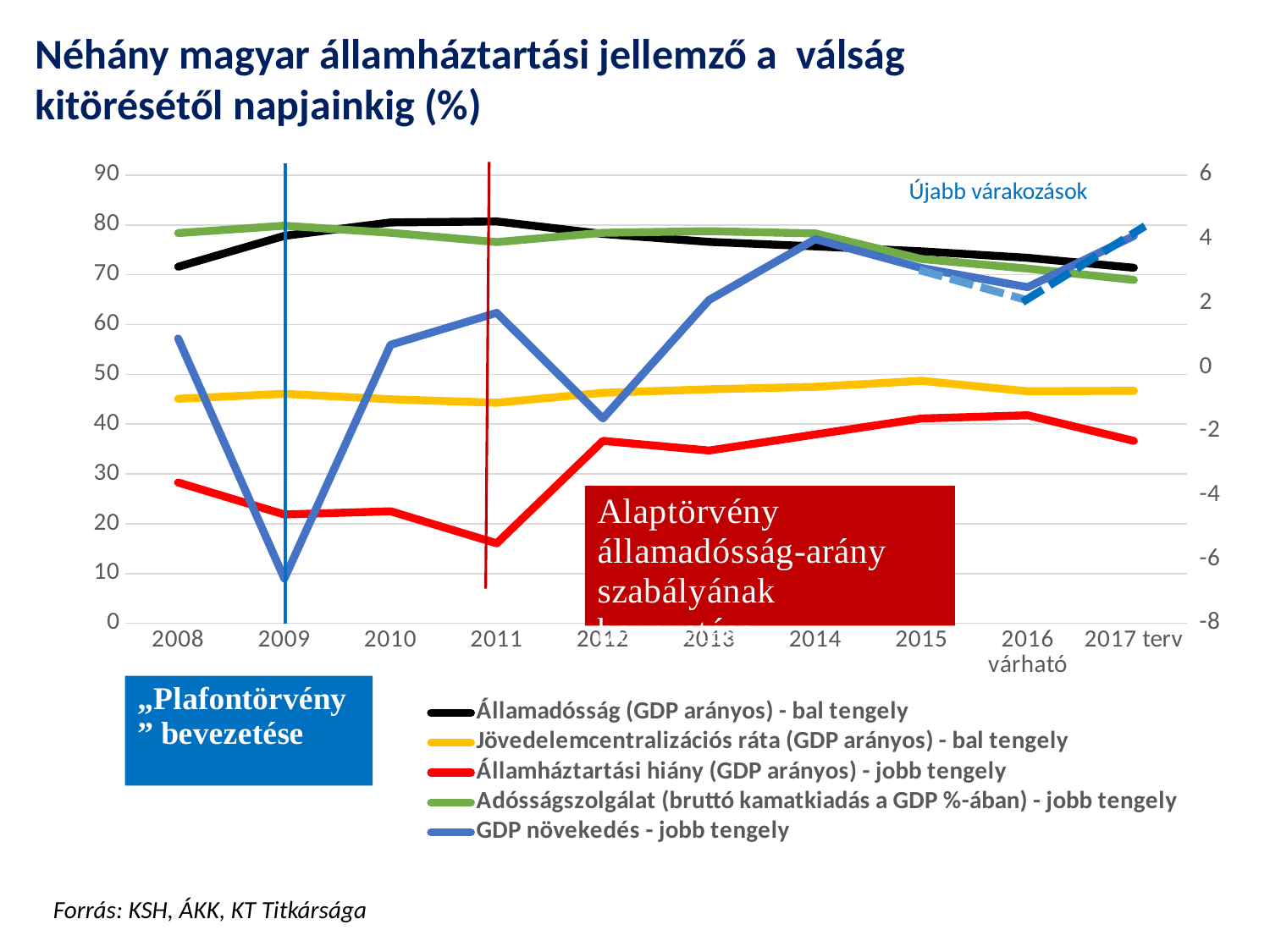
Which is larger for Államadósság (GDP arányos): the value in 2011 or in 2017 terv? 2011 Is the value for Államháztartási hiány (GDP arányos) in 2011 greater or less than -4 on the right axis? less Does Államadósság (GDP arányos) rise or fall from 2011 to 2017 terv? fall Is the value for GDP növekedés in 2009 greater or less than -6 on the right axis? less How many series does the legend list? 5 In which year is Államháztartási hiány (GDP arányos) at its lowest? 2011 Which series is drawn with the black line according to the legend? Államadósság (GDP arányos) - bal tengely In which year is GDP növekedés at its lowest? 2009 What kind of chart is shown on the slide? line chart How many years (categories) are shown on the x axis? 10 Is the value for Adósságszolgálat in 2009 greater or less than 4 on the right axis? greater